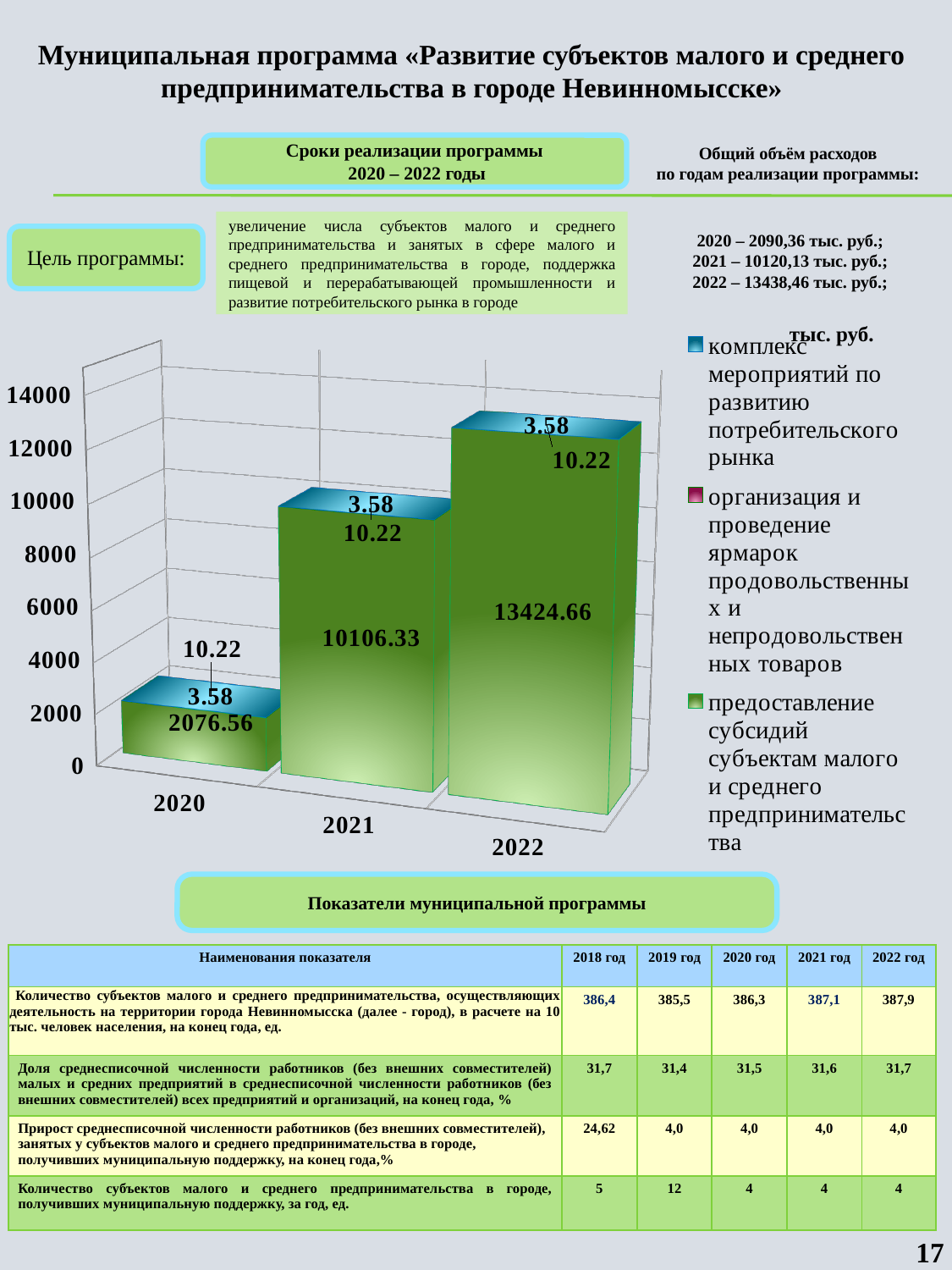
What is the value of the 'предоставление субсидий субъектам малого и среднего предпринимательства' series for 2020? 2076.56 What is the value of the 'предоставление субсидий субъектам малого и среднего предпринимательства' series for 2021? 10106.33 What is the total of the stacked bar for 2020? 2090.36 What type of chart is shown on the slide? bar chart How many series does the chart legend list? 3 What is the value of the 'предоставление субсидий субъектам малого и среднего предпринимательства' series for 2022? 13424.66 Which year has the highest value for the 'предоставление субсидий' series? 2022 How many years (categories) are shown on the x axis of the chart? 3 What is the value of the 'организация и проведение ярмарок продовольственных и непродовольственных товаров' series for 2022? 3.58 What is the difference between the 'предоставление субсидий' values for 2022 and 2021? 3318.33 What is the value of the 'комплекс мероприятий по развитию потребительского рынка' series for 2021? 10.22 Which year has the lowest total bar? 2020